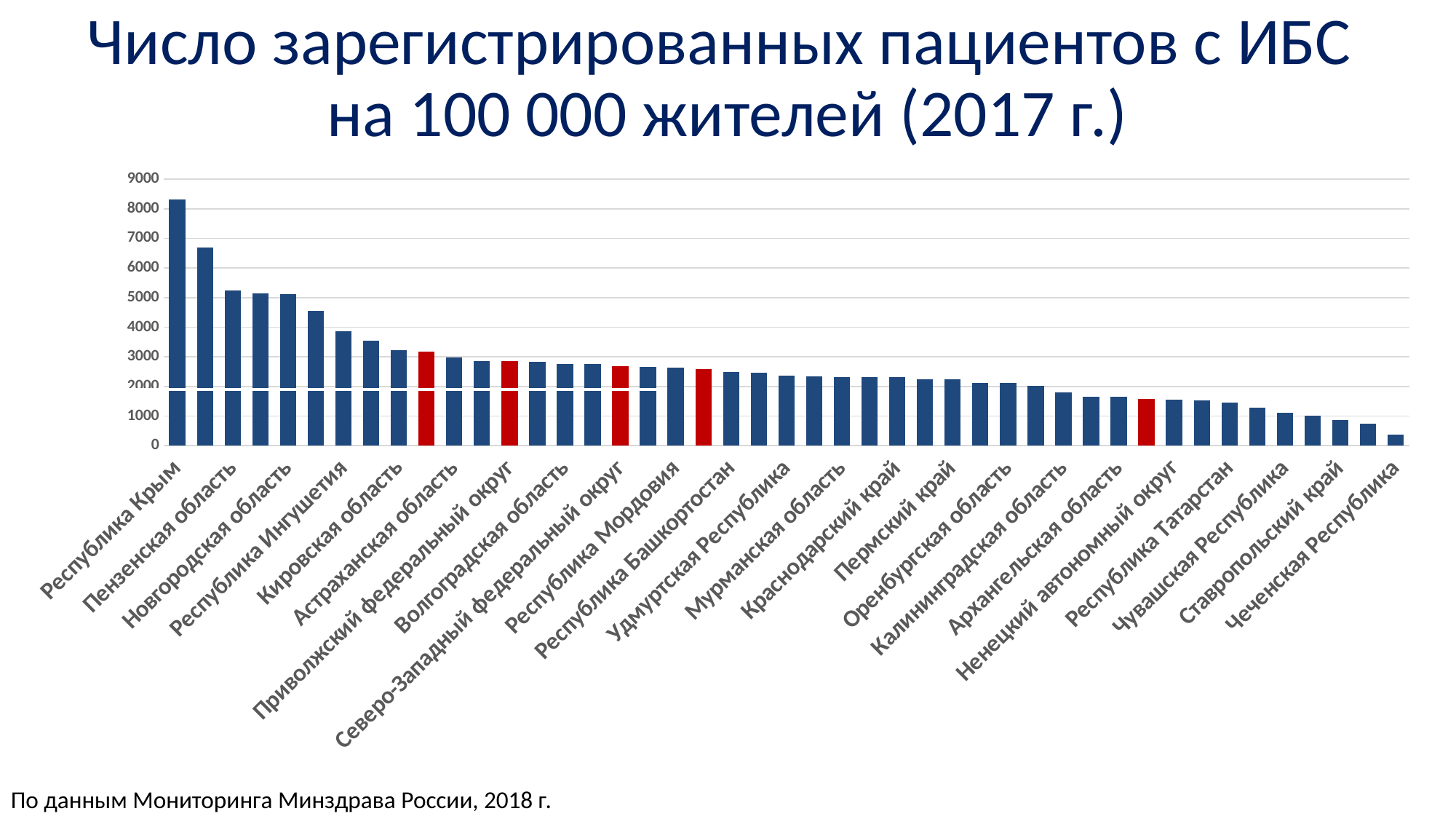
What is the title of the chart? Число зарегистрированных пациентов с ИБС на 100 000 жителей (2017 г.) Which region has the lowest value on the chart? Чеченская Республика What kind of chart is shown on the slide? bar chart Which region has the highest number of registered patients with ИБС per 100 000 residents? Республика Крым Which is larger, the value for Пензенская область or the value for Ставропольский край? Пензенская область Do the values rise or fall moving from left to right along the x axis? fall What data source is cited at the bottom of the slide? По данным Мониторинга Минздрава России, 2018 г. Which is larger, the value for Республика Крым or the value for Чеченская Республика? Республика Крым Is the value for Республика Татарстан greater or less than 2000? less Is the value for Республика Крым greater or less than 7000? greater Is the value for Пензенская область greater or less than 4000? greater